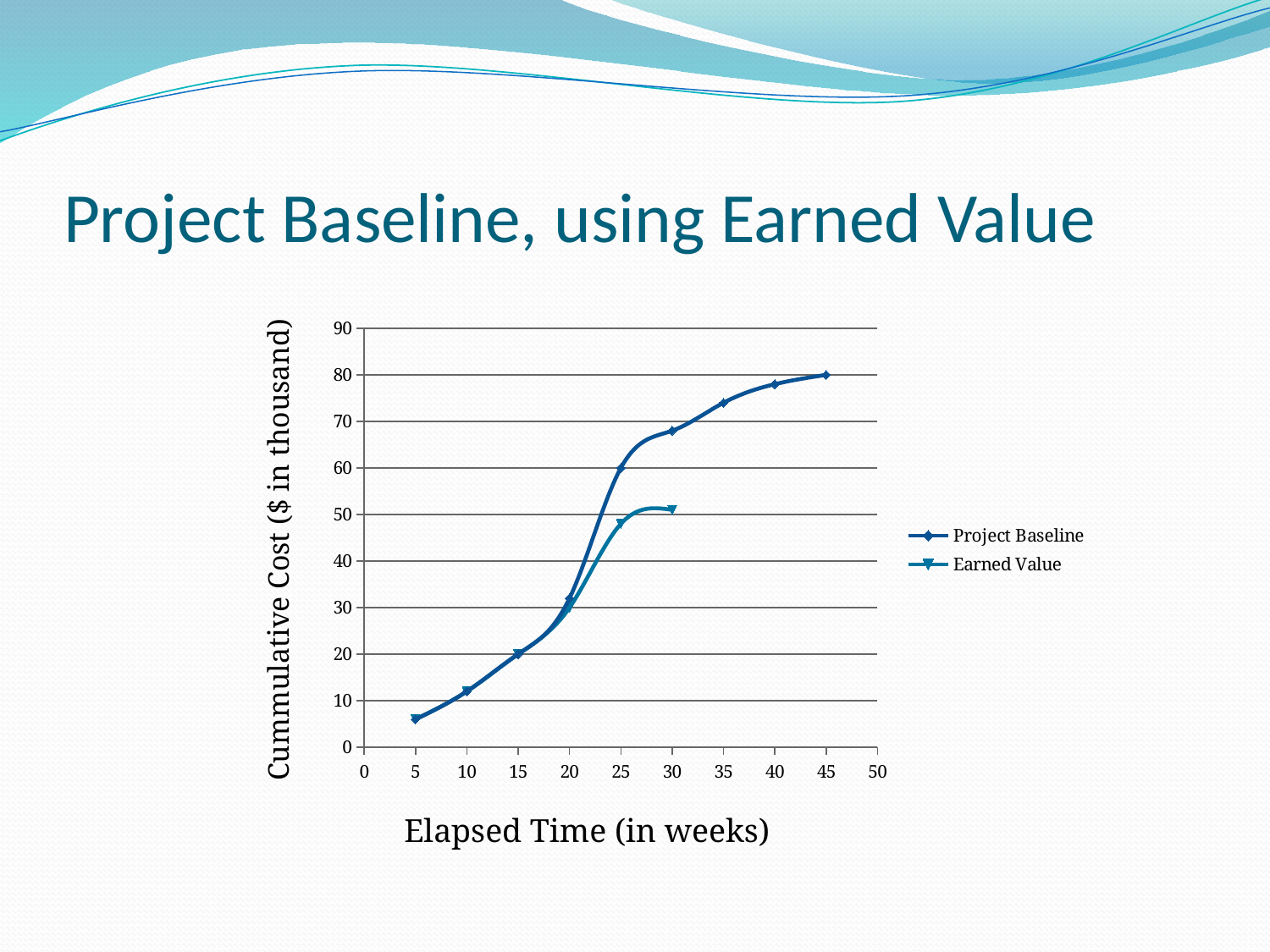
What kind of chart is shown on the slide? line chart Is the Project Baseline value at 10 weeks greater or less than 20? less At which elapsed time does the Project Baseline series reach its highest value? 45 weeks What is the title of the x axis? Elapsed Time (in weeks) Is the Earned Value at 30 weeks greater or less than 60? less Is the Project Baseline value at 30 weeks greater or less than 60? greater How many series does the legend list? 2 At 25 weeks, which series has the higher value, Project Baseline or Earned Value? Project Baseline What are the two series named in the legend? Project Baseline and Earned Value Does the Project Baseline series rise or fall as elapsed time increases? rise How many data points are plotted for the Earned Value series? 6